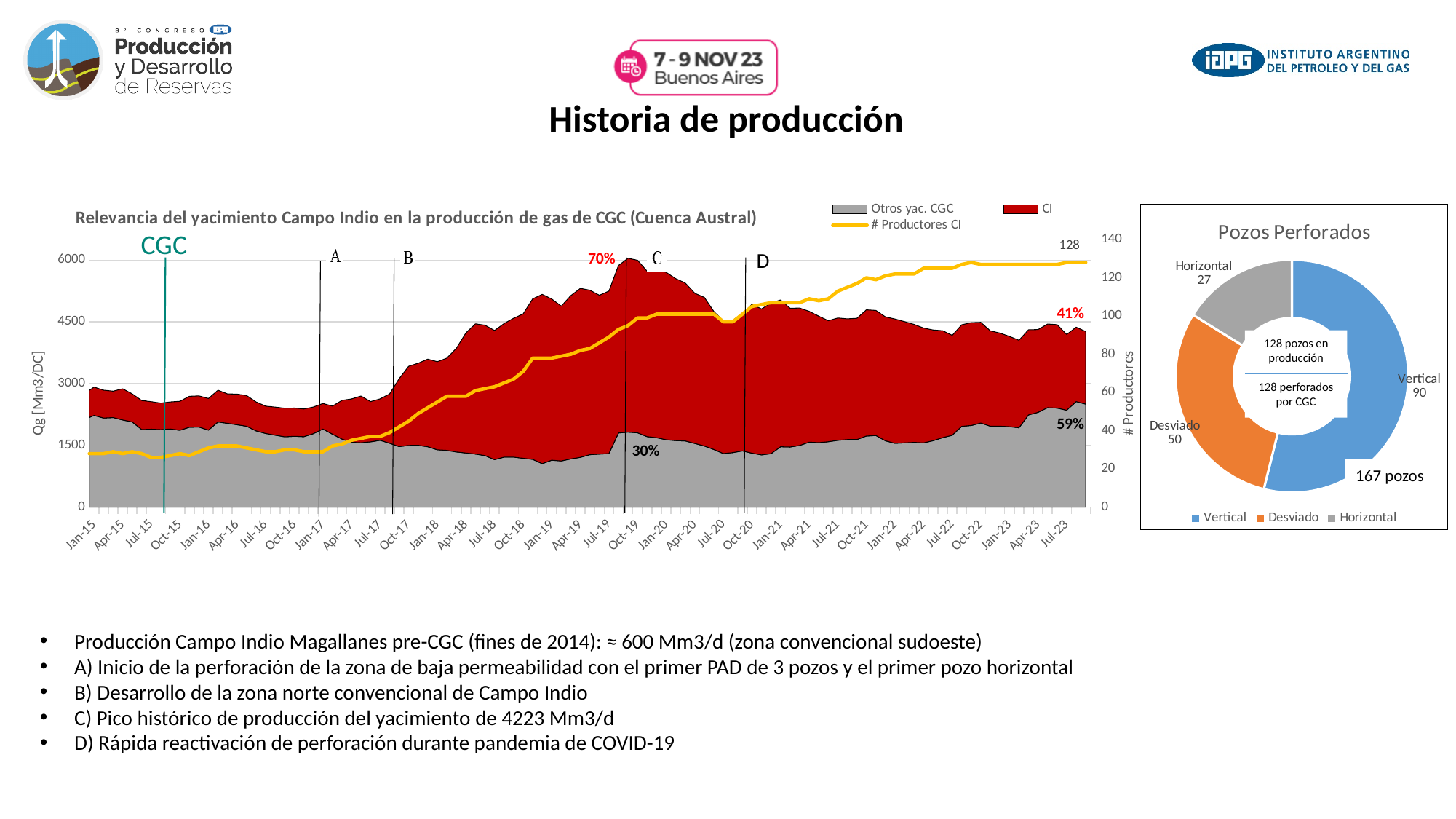
In the chart 'Relevancia del yacimiento Campo Indio en la producción de gas de CGC (Cuenca Austral)', does the '# Productores CI' line rise or fall from Jan-15 to Jul-23? Rise In the 'Pozos Perforados' chart, how many Vertical wells are shown? 90 In the 'Pozos Perforados' chart, which category has the largest number of wells? Vertical How many categories does the legend of the 'Pozos Perforados' chart list? 3 In the 'Pozos Perforados' chart, which category has the smallest number of wells? Horizontal In the chart 'Relevancia del yacimiento Campo Indio en la producción de gas de CGC (Cuenca Austral)', how many series does the legend list? 3 In the chart 'Relevancia del yacimiento Campo Indio en la producción de gas de CGC (Cuenca Austral)', what is the final value labelled for '# Productores CI'? 128 In the 'Pozos Perforados' chart, what is the value for Horizontal? 27 In the 'Pozos Perforados' chart, what is the total number of wells shown? 167 pozos In the 'Pozos Perforados' chart, what is the value for Desviado? 50 In the 'Pozos Perforados' chart, how many more Vertical wells are there than Desviado wells? 40 What kind of chart is 'Pozos Perforados'? Pie (donut) chart